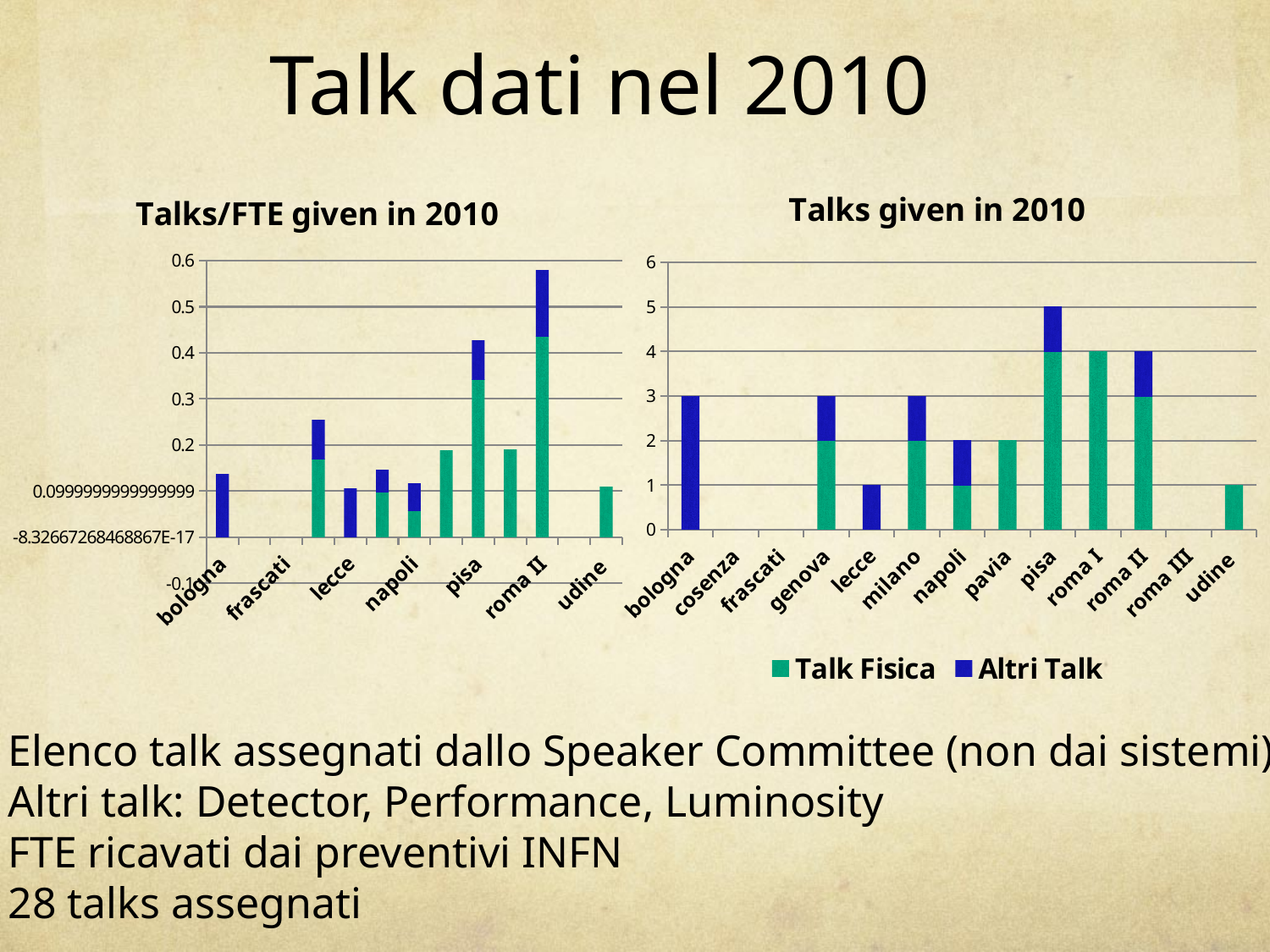
In the 'Talks given in 2010' chart, which has a larger total, genova or napoli? genova In the 'Talks given in 2010' chart, how many Talk Fisica does roma II have? 3 What type of chart is the 'Talks given in 2010' chart? Stacked bar chart In the 'Talks given in 2010' chart, what is the total number of talks for pisa? 5 In the 'Talks given in 2010' chart, what is the difference between the total talks for pisa and roma I? 1 In the 'Talks/FTE given in 2010' chart, is the total value for roma II greater or less than 0.5? greater How many series does the legend of the 'Talks given in 2010' chart list? 2 In the 'Talks/FTE given in 2010' chart, which site has the highest total value? roma II In the 'Talks given in 2010' chart, which site has the highest total number of talks? pisa What are the two legend entries shown below the 'Talks given in 2010' chart? Talk Fisica and Altri Talk How many sites are listed on the x axis of the 'Talks given in 2010' chart? 13 In the 'Talks given in 2010' chart, how many Altri Talk does bologna have? 3